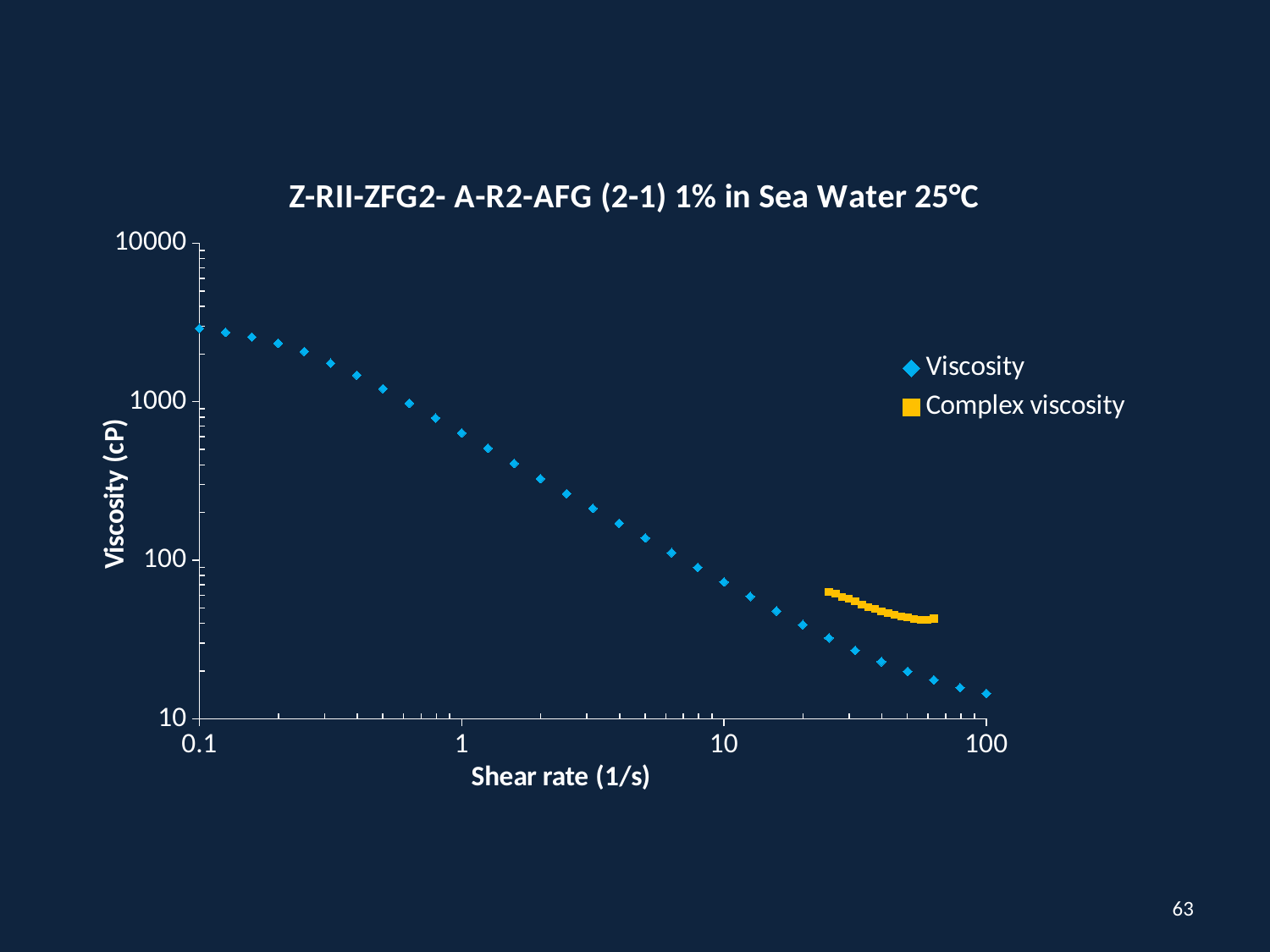
How many series does the legend list? 2 At which shear rate does the Viscosity series reach its highest value? 0.1 1/s Does the Viscosity series rise or fall as shear rate increases along the x axis? fall Is the Viscosity value at a shear rate of 100 1/s greater or less than 100 cP? less Is the Viscosity value at a shear rate of 1 1/s greater or less than 100 cP? greater Are the Complex viscosity values greater or less than 100 cP? less What is the title of the chart? Z-RII-ZFG2- A-R2-AFG (2-1) 1% in Sea Water 25°C What kind of chart is shown on the slide? scatter chart At a shear rate of about 30 1/s, which series has the higher value, Viscosity or Complex viscosity? Complex viscosity Which two series are listed in the legend? Viscosity and Complex viscosity